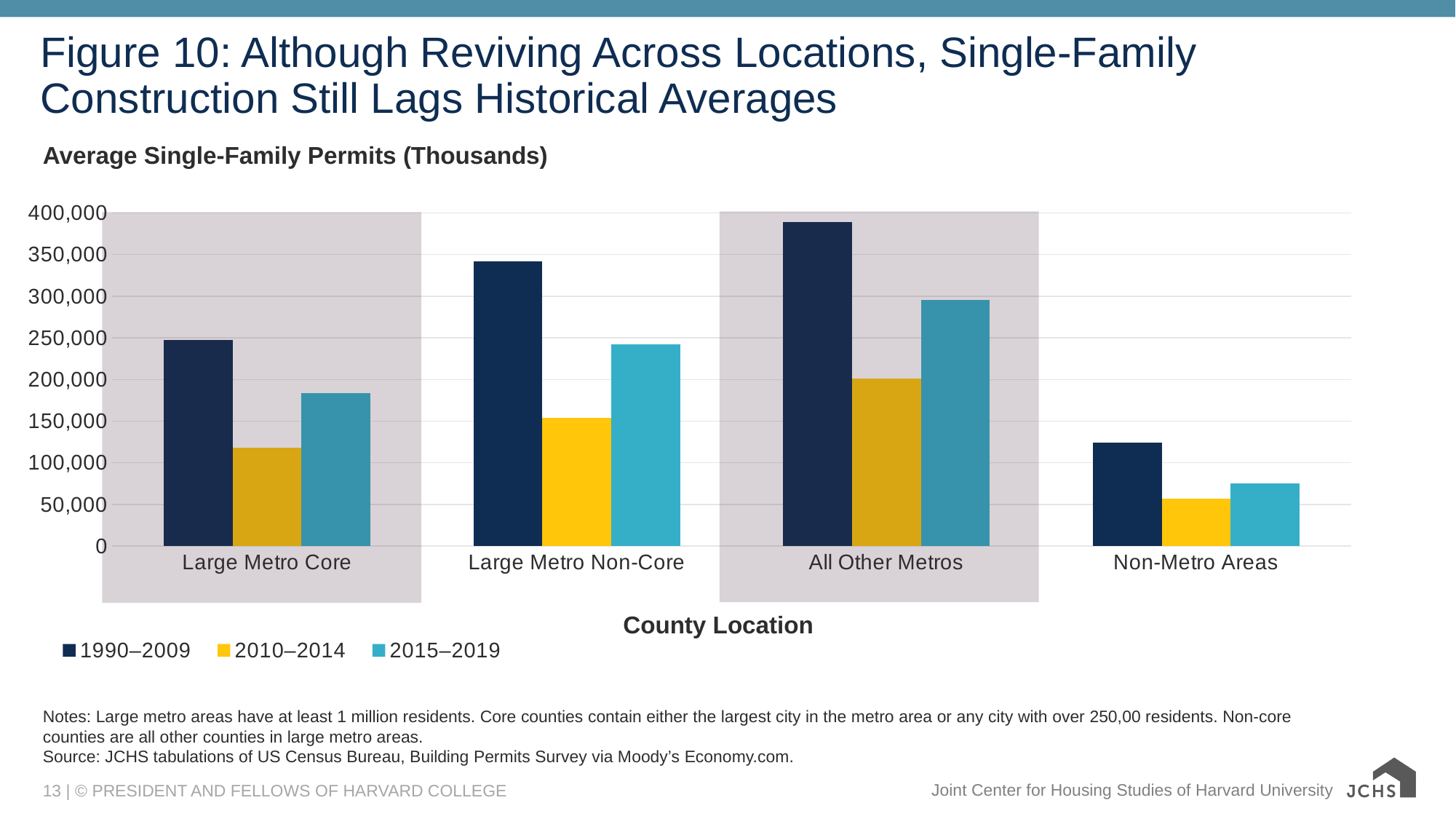
Is the 2015–2019 value for Large Metro Non-Core greater or less than 300,000? less Which is larger: the 2015–2019 value for Large Metro Non-Core or the 2015–2019 value for Large Metro Core? Large Metro Non-Core How many county location categories are shown on the x axis? 4 How many series does the legend list? 3 Is the 2010–2014 value for Non-Metro Areas greater or less than 100,000? less Which series is shown in yellow in the legend? 2010–2014 Is the 1990–2009 value for Large Metro Core greater or less than 200,000? greater What is the title of the x axis? County Location Which county location has the lowest 2010–2014 value? Non-Metro Areas What kind of chart is shown on the slide? Bar chart Which county location has the highest 1990–2009 value? All Other Metros